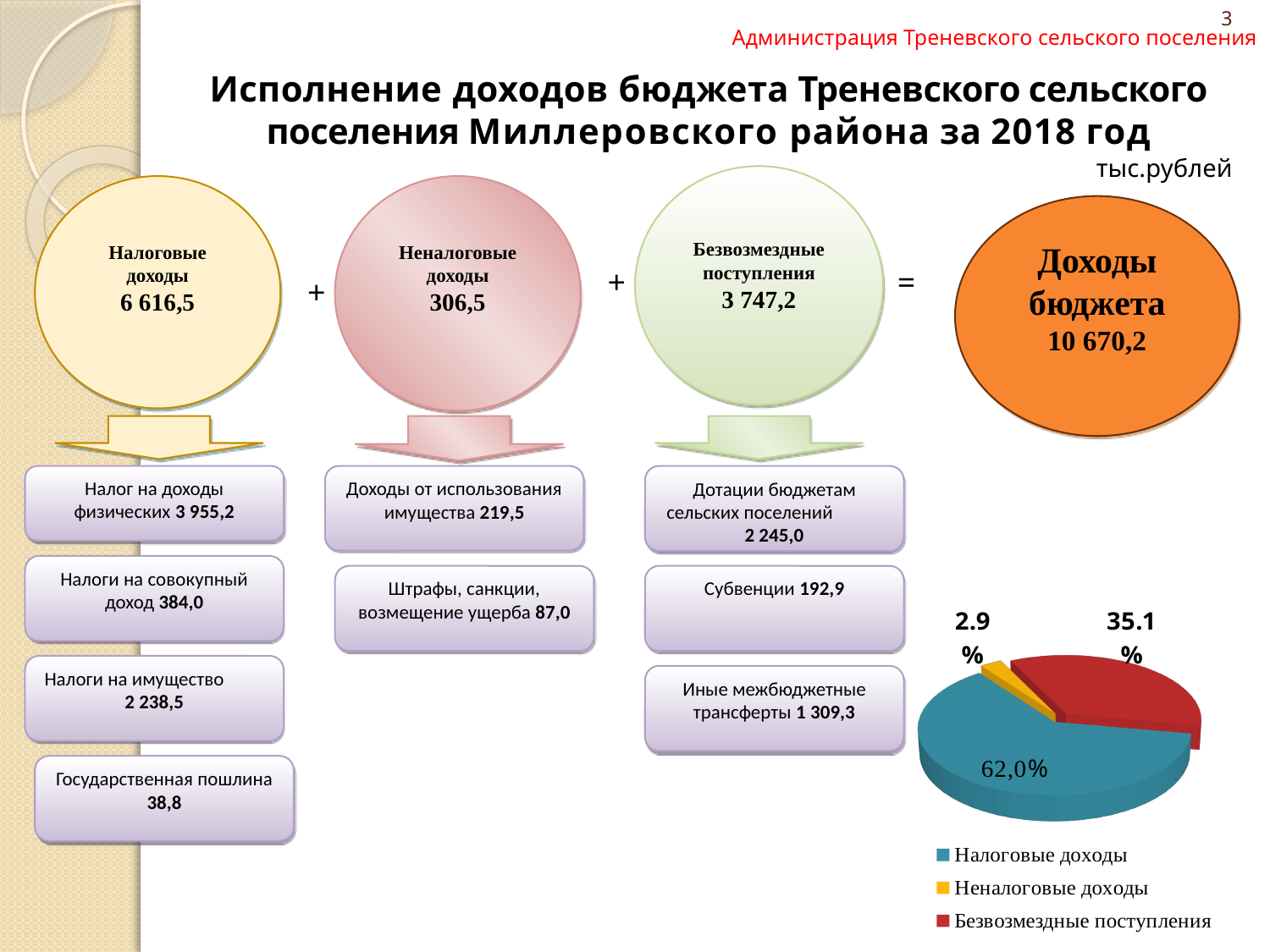
How many entries does the pie chart's legend list? 3 Which category has the smallest slice in the pie chart? Неналоговые доходы Which category has the largest slice in the pie chart? Налоговые доходы In the pie chart, what share is shown for Неналоговые доходы? 2.9% What colour is the Безвозмездные поступления slice in the pie chart? red How many slices does the pie chart have? 3 In the pie chart, what share is shown for Налоговые доходы? 62,0% In the pie chart, is the share for Налоговые доходы greater or less than 50%? greater What kind of chart is shown in the bottom right of the slide? pie chart In the pie chart, what share is shown for Безвозмездные поступления? 35.1% In the pie chart, by how many percentage points does Безвозмездные поступления exceed Неналоговые доходы? 32.2 In the pie chart, which is larger: Безвозмездные поступления or Неналоговые доходы? Безвозмездные поступления